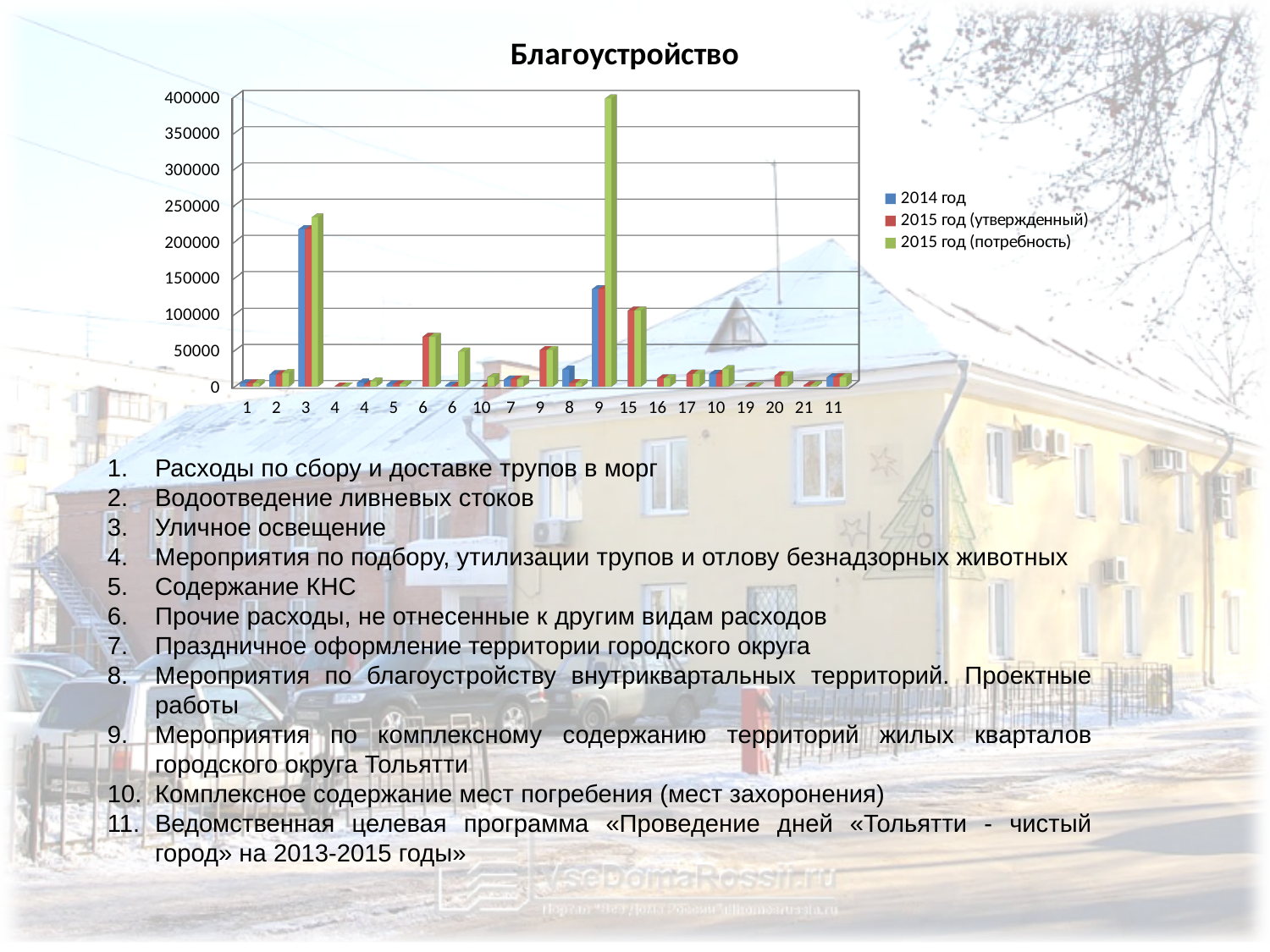
How many categories are shown along the x axis of the chart? 21 What is the title of the chart? Благоустройство What kind of chart is shown on the slide? bar chart Is the value for category 3 in the 2015 год (потребность) series greater or less than 250000? less Is the value for category 8 in the 2014 год series greater or less than 50000? less How many series does the chart legend list? 3 For the 2014 год series, which category has the highest value? 3 Which series contains the tallest bar in the chart? 2015 год (потребность) Is the value for category 3 in the 2014 год series greater or less than 200000? greater Which series is shown in green in the chart? 2015 год (потребность) For the 2014 год series, which is larger: the value for category 3 or the value for category 2? category 3